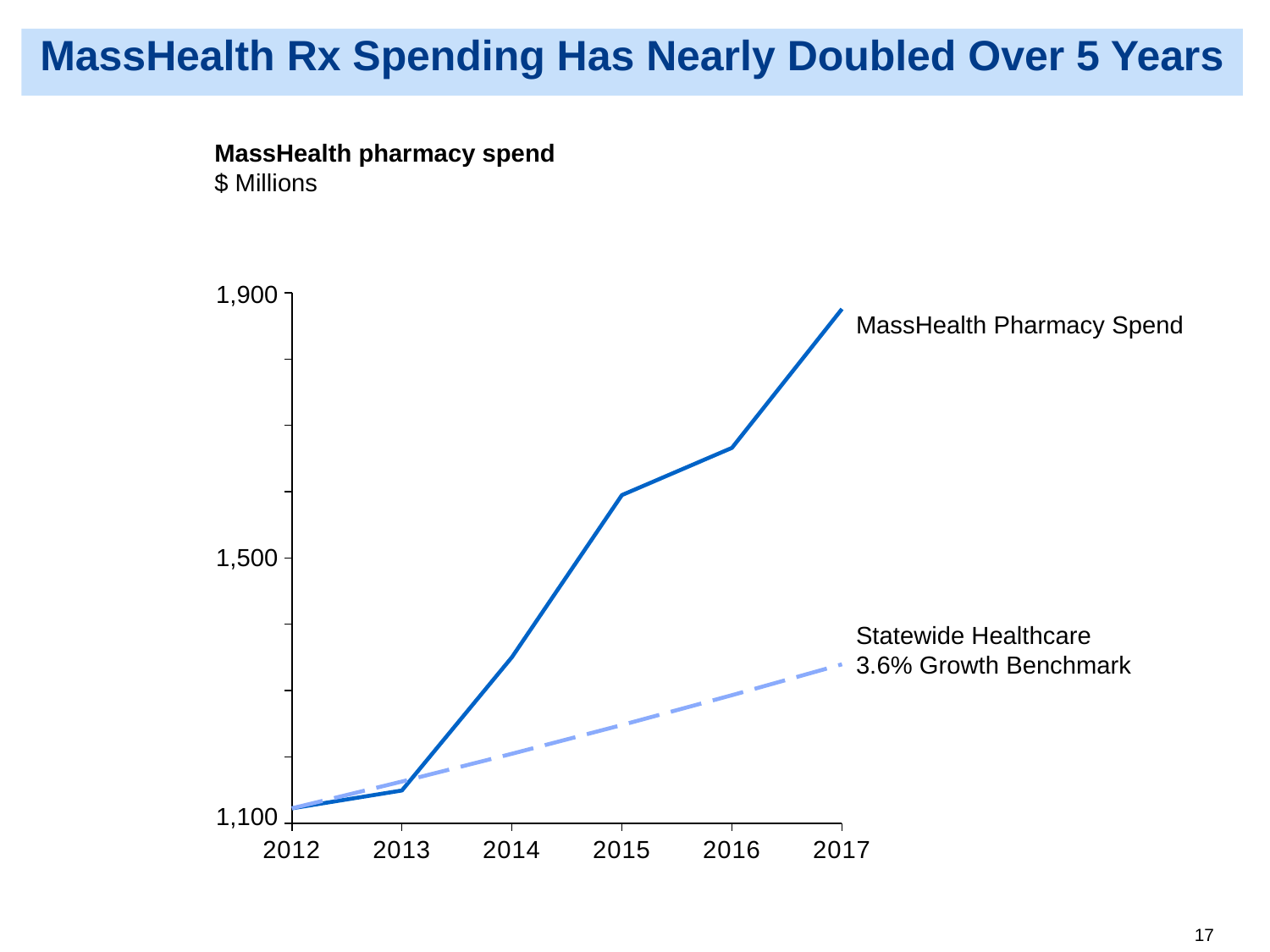
What kind of chart is shown on the slide? line chart How many years are shown on the x axis of the chart? 6 In which year is MassHealth Pharmacy Spend highest? 2017 Is the MassHealth Pharmacy Spend value for 2017 greater or less than 1,500? greater Is the MassHealth Pharmacy Spend value for 2014 greater or less than 1,500? less Which series is drawn as a dashed line? Statewide Healthcare 3.6% Growth Benchmark Is the Statewide Healthcare 3.6% Growth Benchmark value for 2017 greater or less than 1,500? less In 2017, which is larger: MassHealth Pharmacy Spend or the Statewide Healthcare 3.6% Growth Benchmark? MassHealth Pharmacy Spend In which year is MassHealth Pharmacy Spend lowest? 2012 Does MassHealth Pharmacy Spend rise or fall from 2012 to 2017? rise What unit is the chart's y axis measured in? $ Millions How many series are plotted on the chart? 2